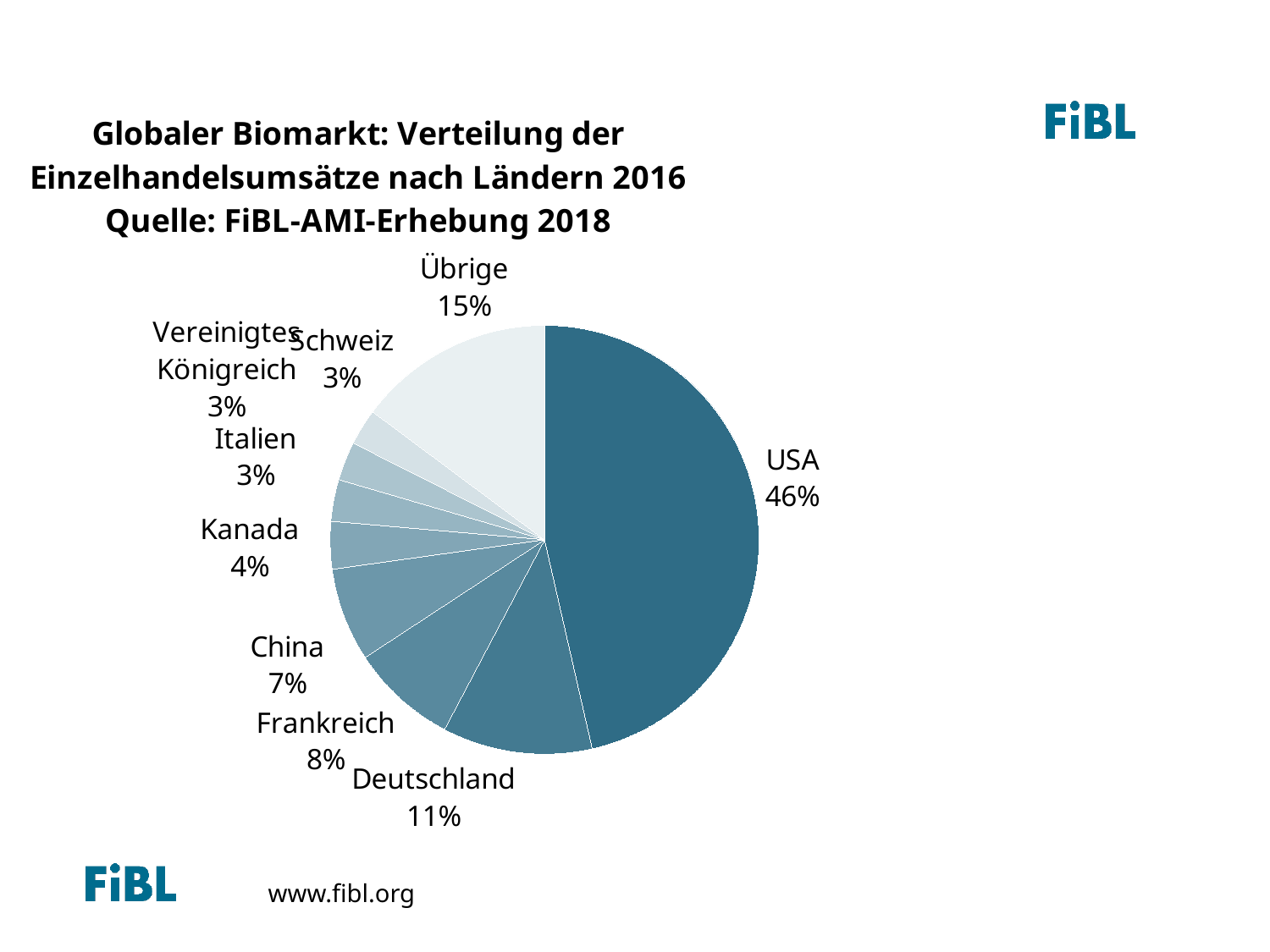
How many slices does the pie chart have? 9 Which has a larger share, Übrige or Deutschland? Übrige What is the value shown for Deutschland? 11% What is the difference between the shares of China and Kanada? 3% What is the difference between the shares of USA and Deutschland? 35% What share of the pie does USA have? 46% What share is shown for Übrige? 15% What percentage is shown for Frankreich? 8% What kind of chart is shown on the slide? Pie chart Which has a larger share, Frankreich or China? Frankreich Which country has the largest slice of the pie? USA What source is cited in the chart title? FiBL-AMI-Erhebung 2018